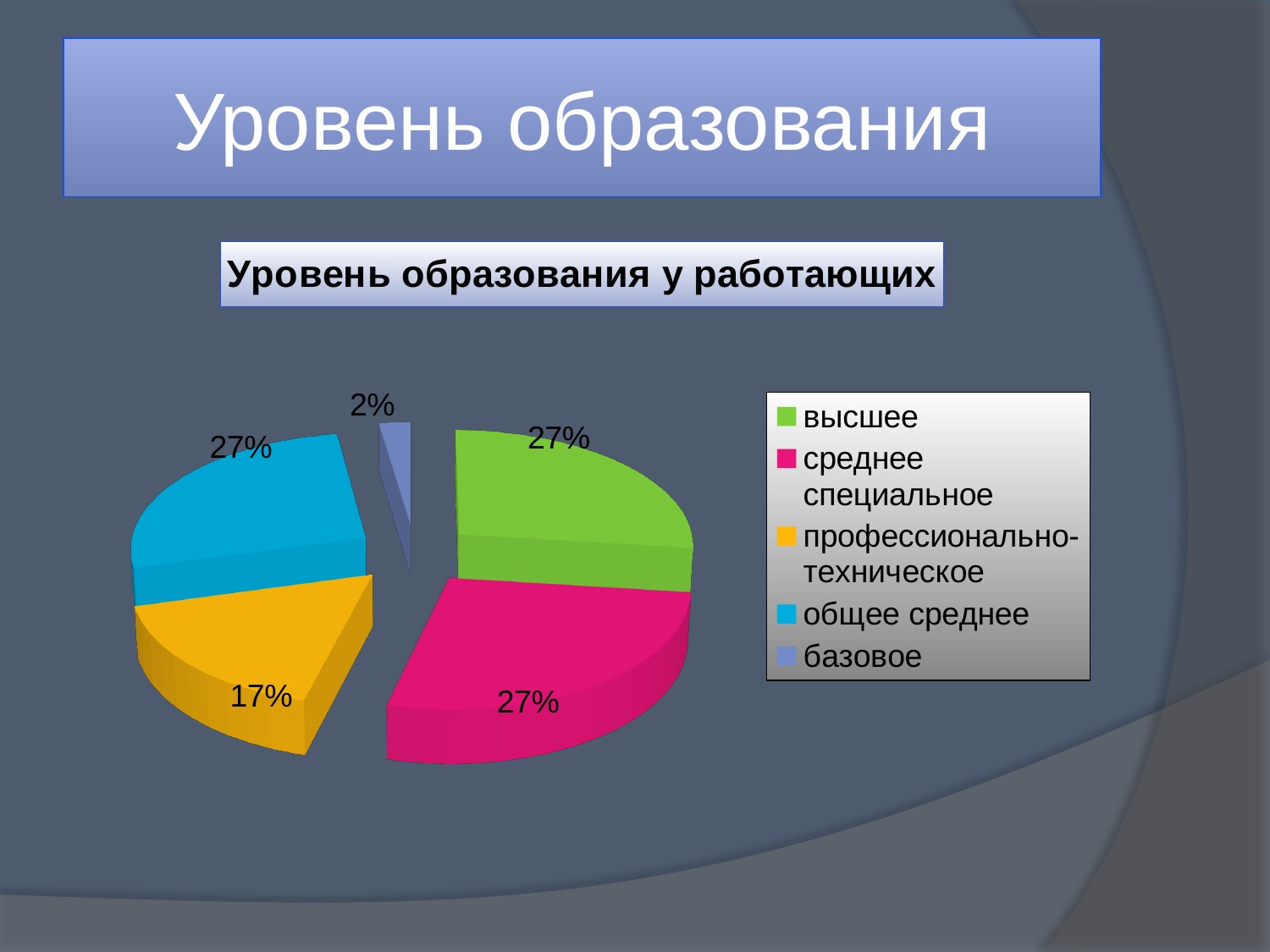
What share of the pie does 'высшее' have? 27% What type of chart is shown on the slide? pie chart What colour is the slice for 'общее среднее'? cyan (light blue) What share of the pie does 'базовое' have? 2% What is the difference between the shares of 'профессионально-техническое' and 'базовое'? 15% Which category has the smallest share of the pie? базовое How many categories does the legend of the pie chart list? 5 What is the title of the chart? Уровень образования у работающих Which is larger: the share of 'профессионально-техническое' or the share of 'базовое'? профессионально-техническое What is the difference between the shares of 'среднее специальное' and 'профессионально-техническое'? 10% What share of the pie does 'профессионально-техническое' have? 17% What share of the pie does 'общее среднее' have? 27%